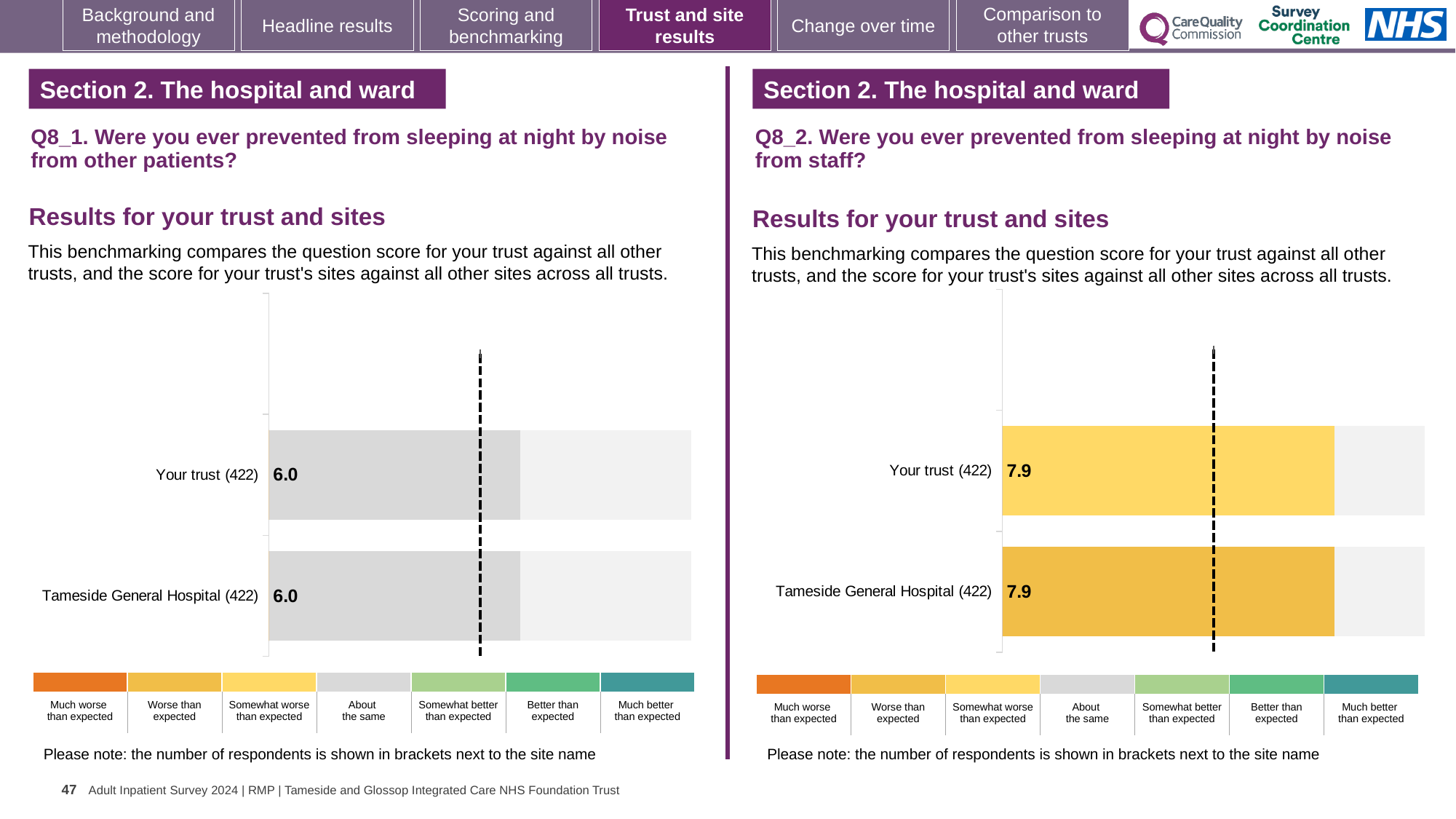
Is the score for Your trust on the Q8_2 chart (right) larger or smaller than the score for Your trust on the Q8_1 chart (left)? Larger On the Q8_2 chart (right), what is the score for Your trust (422)? 7.9 On the Q8_1 chart (left), what is the score for Your trust (422)? 6.0 How many bars are plotted on the Q8_1 chart (left)? 2 On the Q8_1 chart (left), what is the difference between the score for Your trust and the score for Tameside General Hospital? 0.0 How many respondents are shown in brackets next to Tameside General Hospital on the Q8_2 chart (right)? 422 On the Q8_2 chart (right), what is the difference between the score for Your trust and the score for Tameside General Hospital? 0.0 According to the colour key, which benchmark category does the Your trust bar on the Q8_1 chart (left) fall into? About the same How many bars are plotted on the Q8_2 chart (right)? 2 On the Q8_1 chart (left), what is the score for Tameside General Hospital (422)? 6.0 On the Q8_2 chart (right), what is the score for Tameside General Hospital (422)? 7.9 What kind of chart is used on the Q8_2 chart (right)? Bar chart